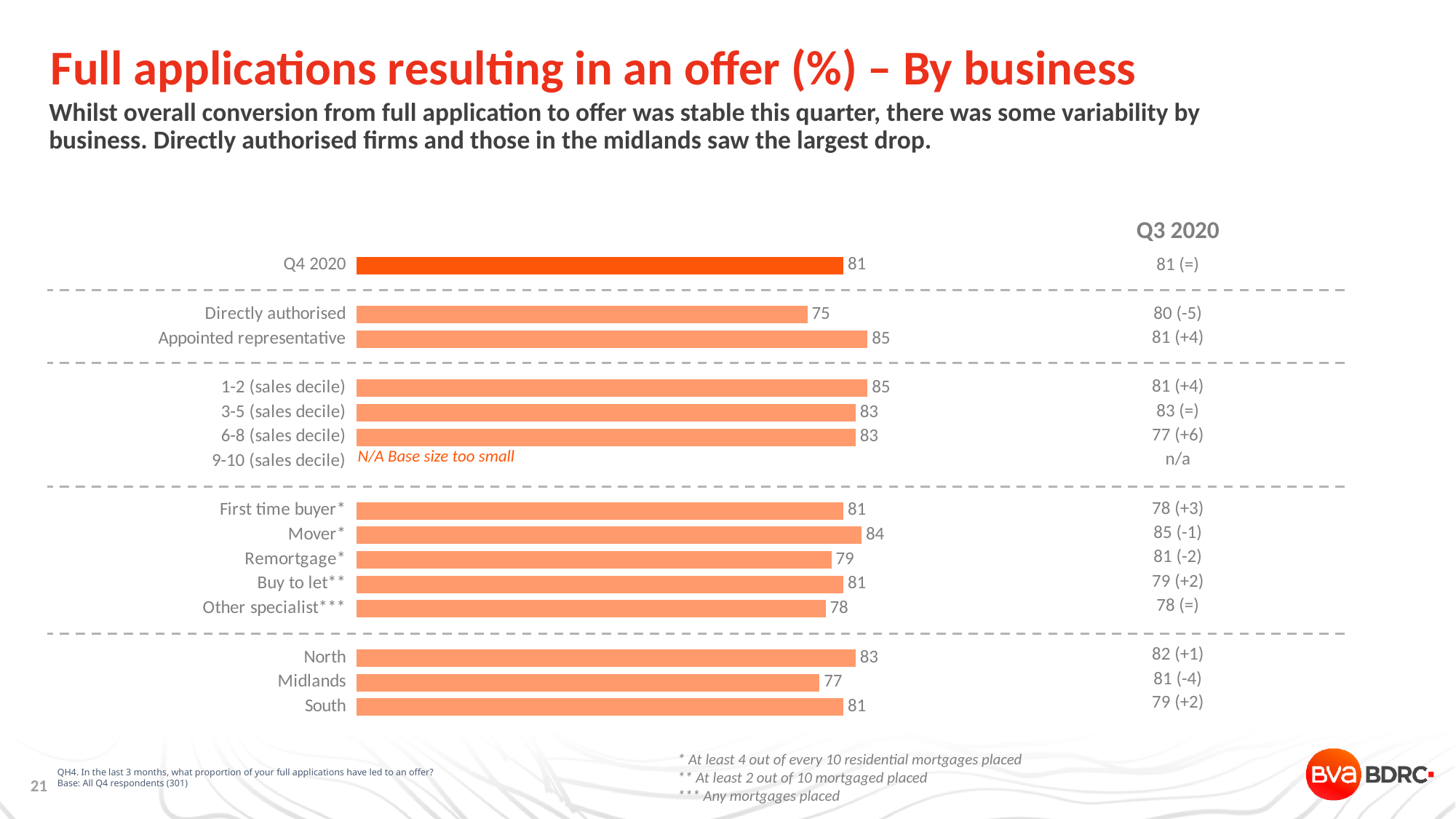
What is the value for the Q4 2020 overall bar? 81 Among the regions (North, Midlands, South), which has the highest value? North What is the value for Midlands? 77 Which category has the lowest value in the chart? Directly authorised Why is there no bar for 9-10 (sales decile)? N/A Base size too small What is the value for Directly authorised? 75 What is the value for Mover? 84 What is the difference between North and Midlands? 6 Which is larger, the value for Mover or the value for Remortgage? Mover What is the difference between Appointed representative and Directly authorised? 10 Which is larger, the value for Other specialist or the value for Buy to let? Buy to let What kind of chart is shown on the slide? Bar chart